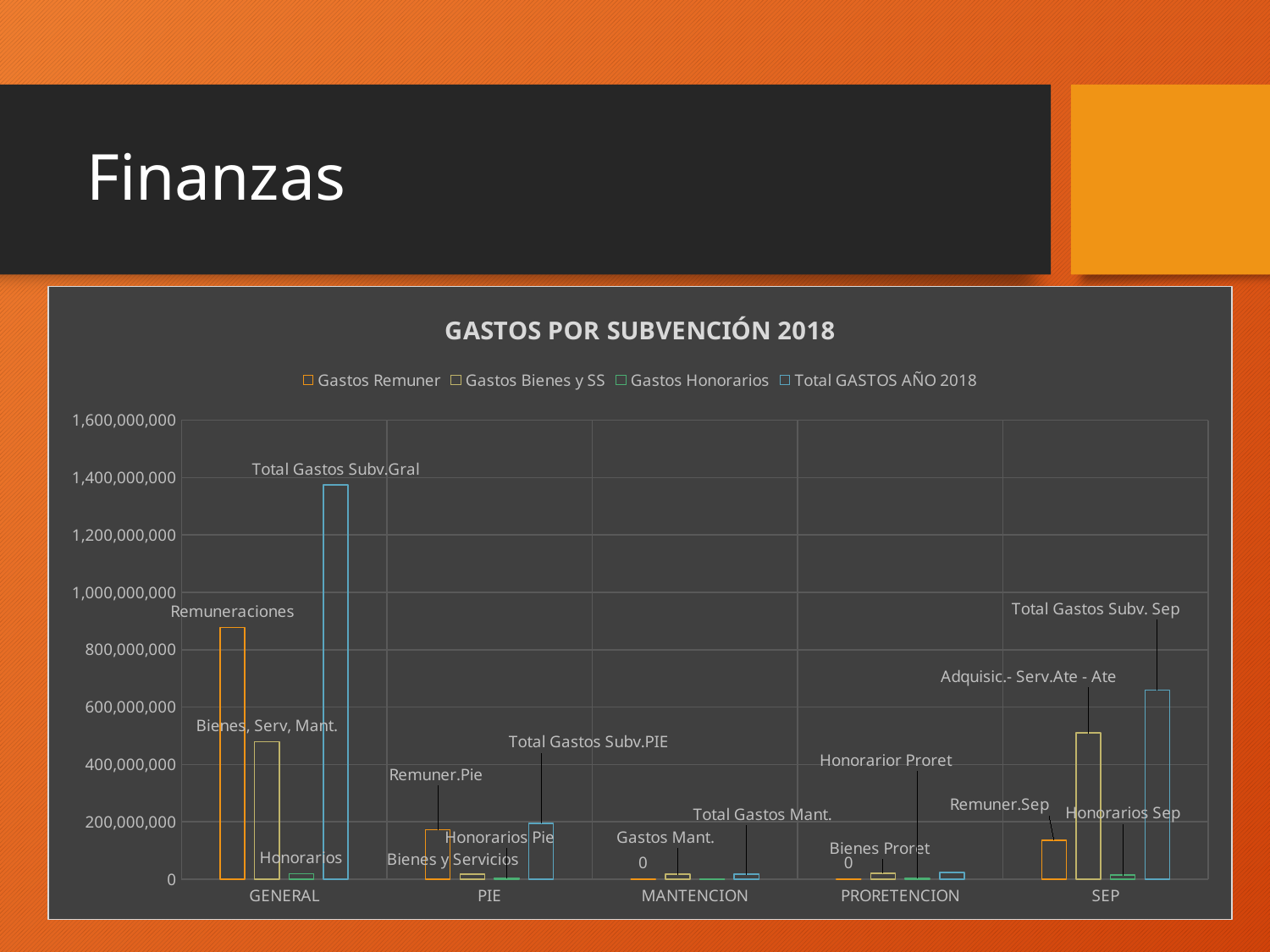
What is the Gastos Remuner value for MANTENCION, as labelled on the chart? 0 Which is larger: the Total GASTOS AÑO 2018 value for GENERAL or for SEP? GENERAL What is the title of the chart? GASTOS POR SUBVENCIÓN 2018 Is the Total GASTOS AÑO 2018 value for SEP greater or less than 600,000,000? greater What kind of chart is shown on the slide? bar chart Is the Gastos Remuner value for GENERAL greater or less than 800,000,000? greater How many series does the chart legend list? 4 How many categories are shown on the x axis of the chart? 5 Is the Gastos Bienes y SS value for SEP greater or less than 400,000,000? greater Which category has the highest value for Total GASTOS AÑO 2018? GENERAL